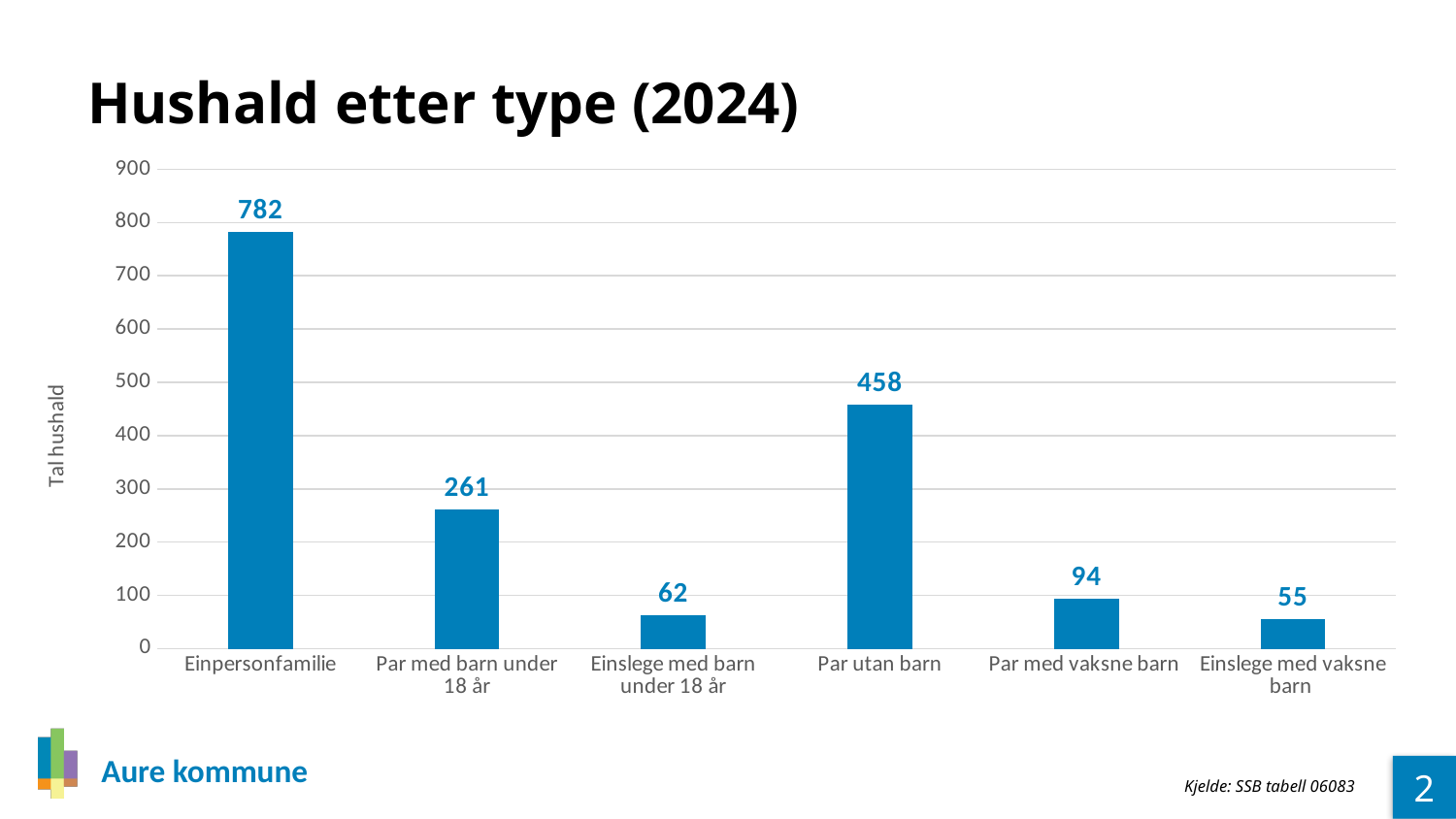
What is the difference between Par med barn under 18 år and Einslege med barn under 18 år? 199 Which is larger, Par med vaksne barn or Einslege med barn under 18 år? Par med vaksne barn What is the difference between Einpersonfamilie and Par utan barn? 324 Which household type has the lowest value? Einslege med vaksne barn How many household types are shown in the chart? 6 What is the value for Einpersonfamilie? 782 What is the value for Par utan barn? 458 What kind of chart is shown on the slide? bar chart What is the title of the chart? Hushald etter type (2024) Which household type has the highest value? Einpersonfamilie Is the value for Par utan barn greater or less than 400? greater What is the value for Einslege med vaksne barn? 55